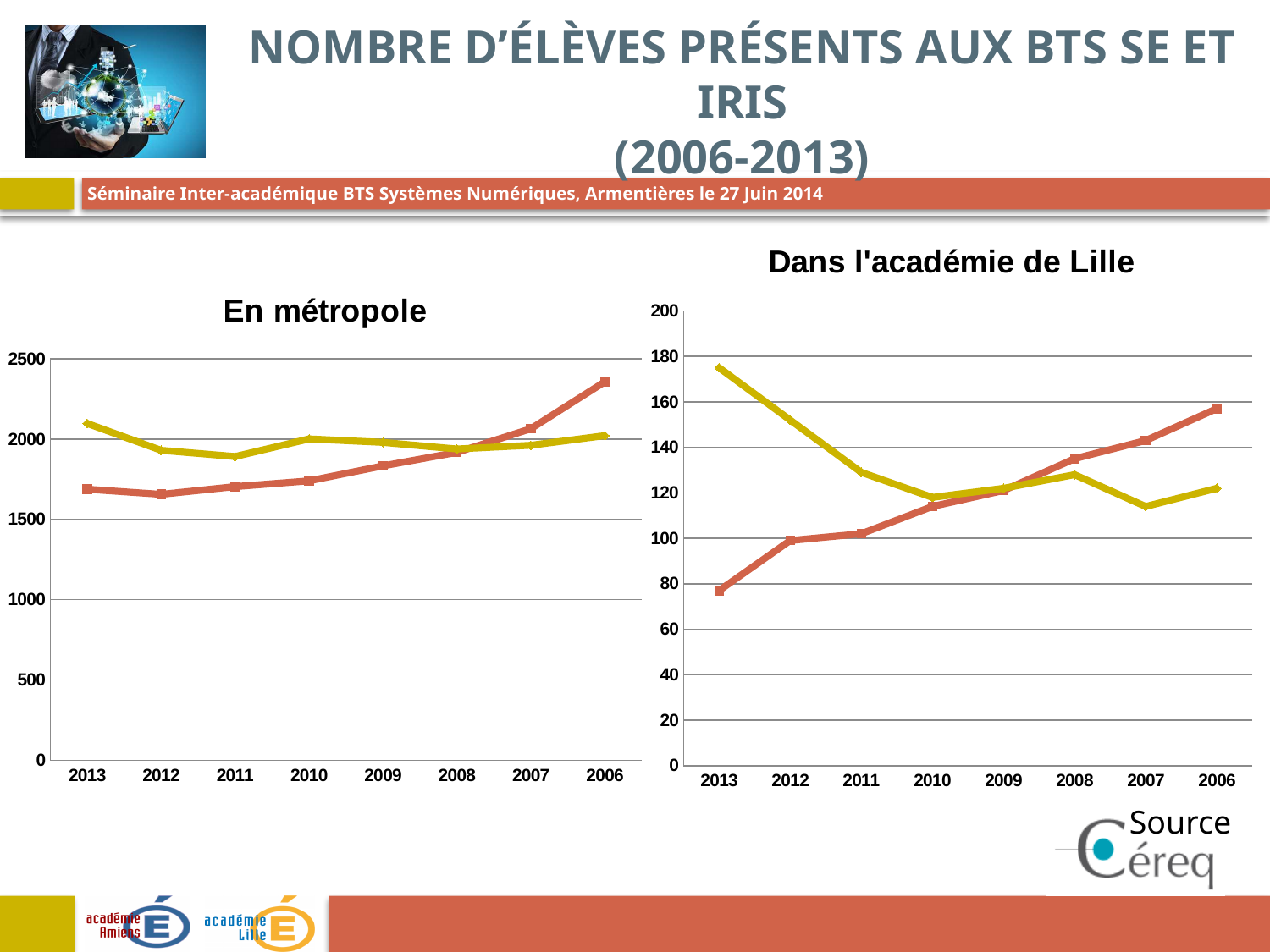
What kind of chart is the 'En métropole' chart? line chart In the 'Dans l'académie de Lille' chart, is the value of the red line for 2006 greater or less than 140? greater In the 'En métropole' chart, is the value of the red line for 2006 greater or less than 2000? greater In the 'Dans l'académie de Lille' chart, is the value of the red line for 2013 greater or less than 100? less What is the title of the chart on the right of the slide? Dans l'académie de Lille In the 'En métropole' chart, which line has the higher value for 2006, the red line or the yellow line? the red line How many years are shown on the x axis of the 'Dans l'académie de Lille' chart? 8 In the 'Dans l'académie de Lille' chart, does the red line rise or fall from left (2013) to right (2006)? rise In the 'Dans l'académie de Lille' chart, which year has the highest value on the yellow line? 2013 In the 'Dans l'académie de Lille' chart, which line has the higher value for 2013, the red line or the yellow line? the yellow line